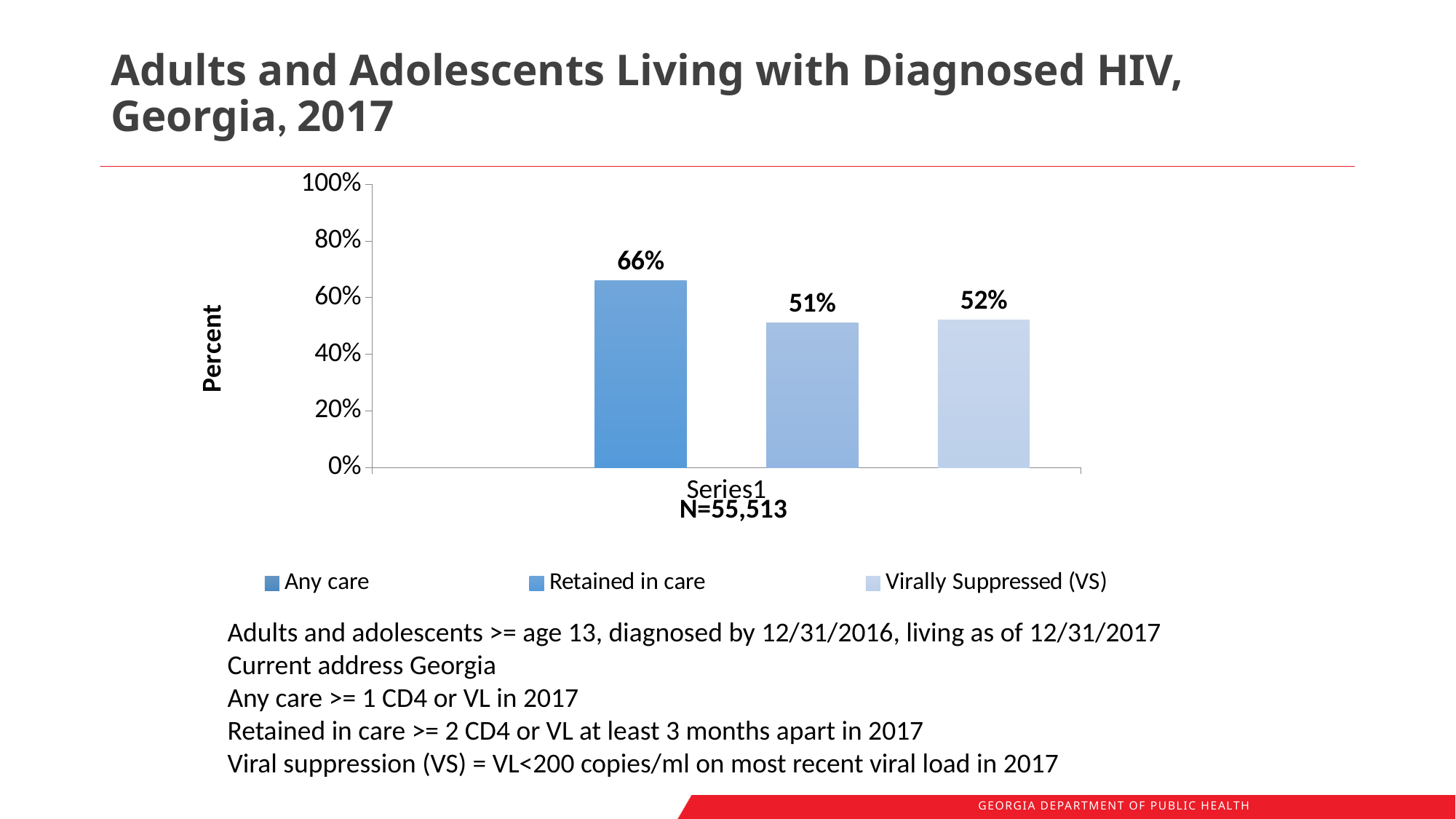
What is the value for Any care? 66% What is the difference between the values for Virally Suppressed (VS) and Retained in care? 1% What is the value for Retained in care? 51% Which series has the highest value? Any care What is the difference between the values for Any care and Retained in care? 15% What is the value for Virally Suppressed (VS)? 52% Which series has the lowest value? Retained in care Is the value for Retained in care greater or less than 60%? less What is the label of the y axis? Percent How many series does the legend list? 3 What kind of chart is shown on the slide? bar chart Is the value for Any care greater or less than 60%? greater